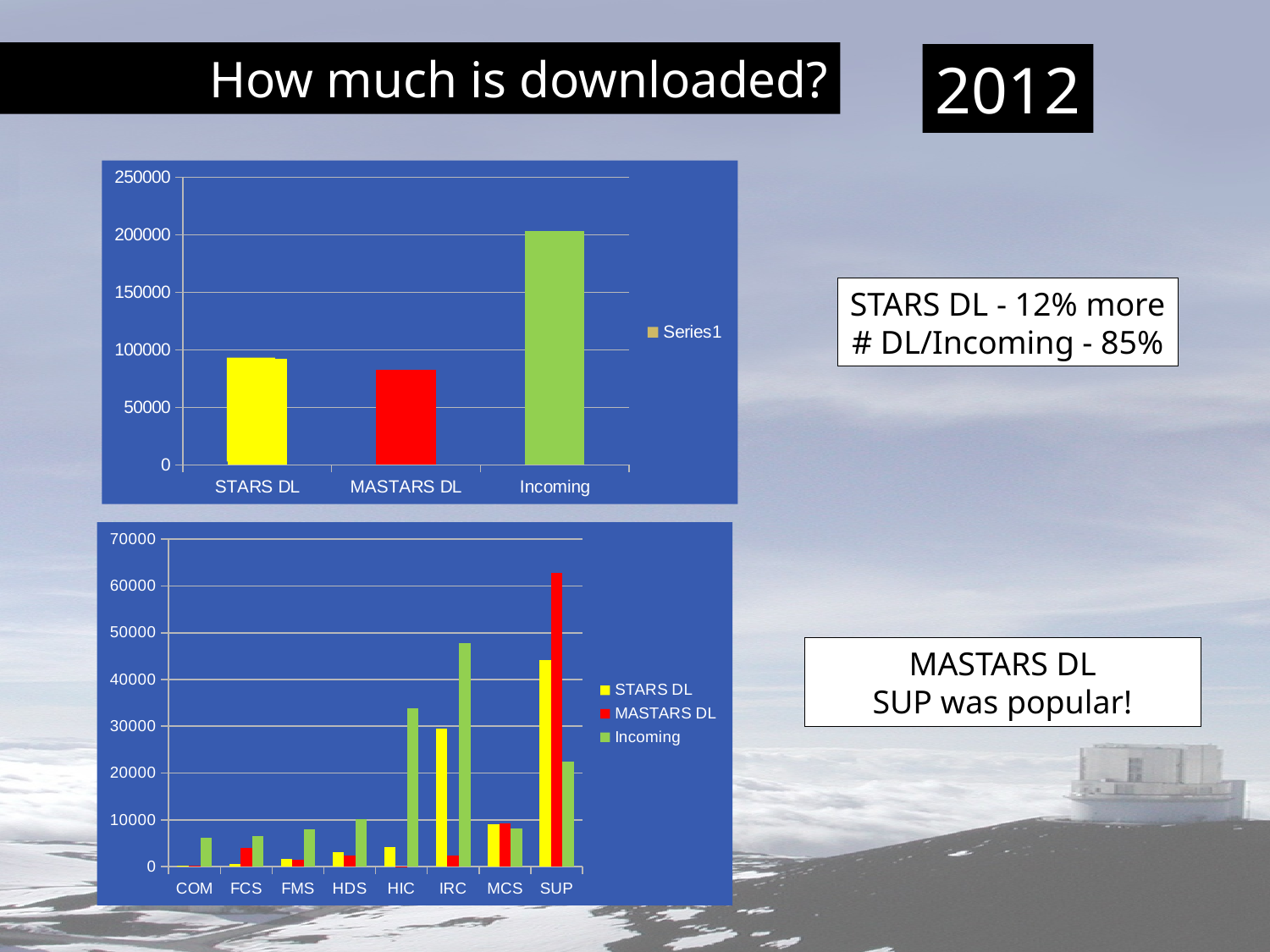
In the bottom chart, which category has the highest Incoming value? IRC In the top chart, which category has the highest value? Incoming In the top chart, what is the name of the series listed in the legend? Series1 In the bottom chart, is the MASTARS DL value for SUP greater or less than 60000? greater In the bottom chart, how many categories are shown on the x axis? 8 In the top chart, is the value for STARS DL greater or less than 100000? less In the top chart, which category has the lowest value? MASTARS DL In the bottom chart, which category has the highest MASTARS DL value? SUP In the bottom chart, how many series does the legend list? 3 In the top chart, is the value for Incoming greater or less than 150000? greater What kind of chart is the top chart on the slide? bar chart In the top chart, how many categories are shown on the x axis? 3